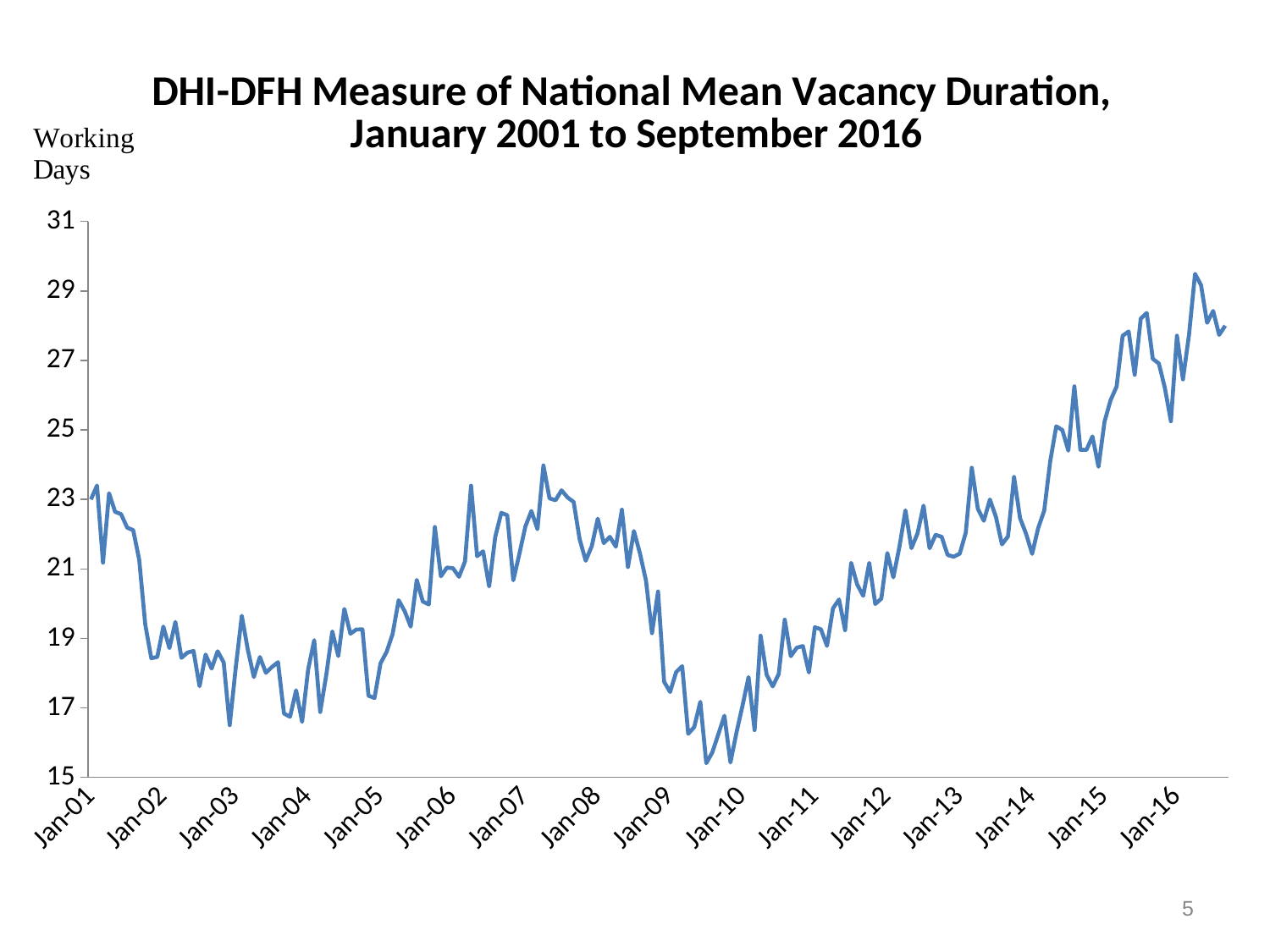
Is the value at Jan-03 greater or less than 21? less What unit is the vertical axis labelled with? Working Days Is the value at Jan-16 greater or less than 25? greater Is the value at Jan-01 greater or less than 21? greater Does the line rise or fall between Jan-01 and Jan-03? fall What is the title of the chart? DHI-DFH Measure of National Mean Vacancy Duration, January 2001 to September 2016 In which year does the line reach its highest point? 2016 What kind of chart is shown on the slide? line chart Does the line rise or fall between Jan-10 and Jan-16? rise